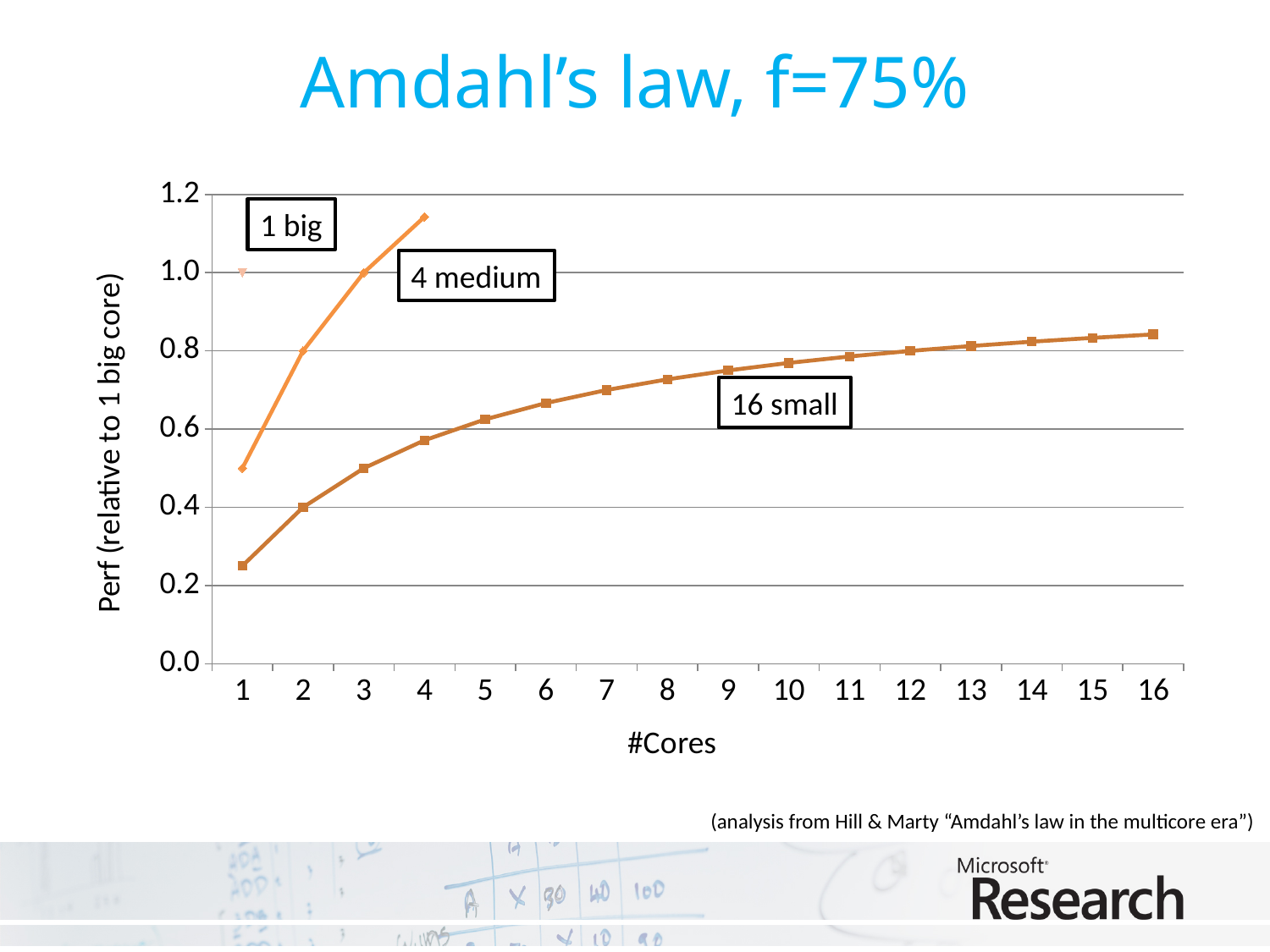
What kind of chart is shown on the slide? line chart What is the value of the 1 big series at 1 core? 1.0 What is the value of the 16 small series at 2 cores? 0.4 Does the 16 small series rise or fall as the number of cores increases? rise How many data points does the 16 small series have? 16 Is the value of the 16 small series at 1 core greater or less than 0.4? less At 4 cores, which series has the higher value, 4 medium or 16 small? 4 medium What is the value of the 4 medium series at 2 cores? 0.8 Is the value of the 4 medium series at 4 cores greater or less than 1.0? greater What is the label of the x axis? #Cores What is the value of the 4 medium series at 3 cores? 1.0 What is the title of the chart? Amdahl's law, f=75%